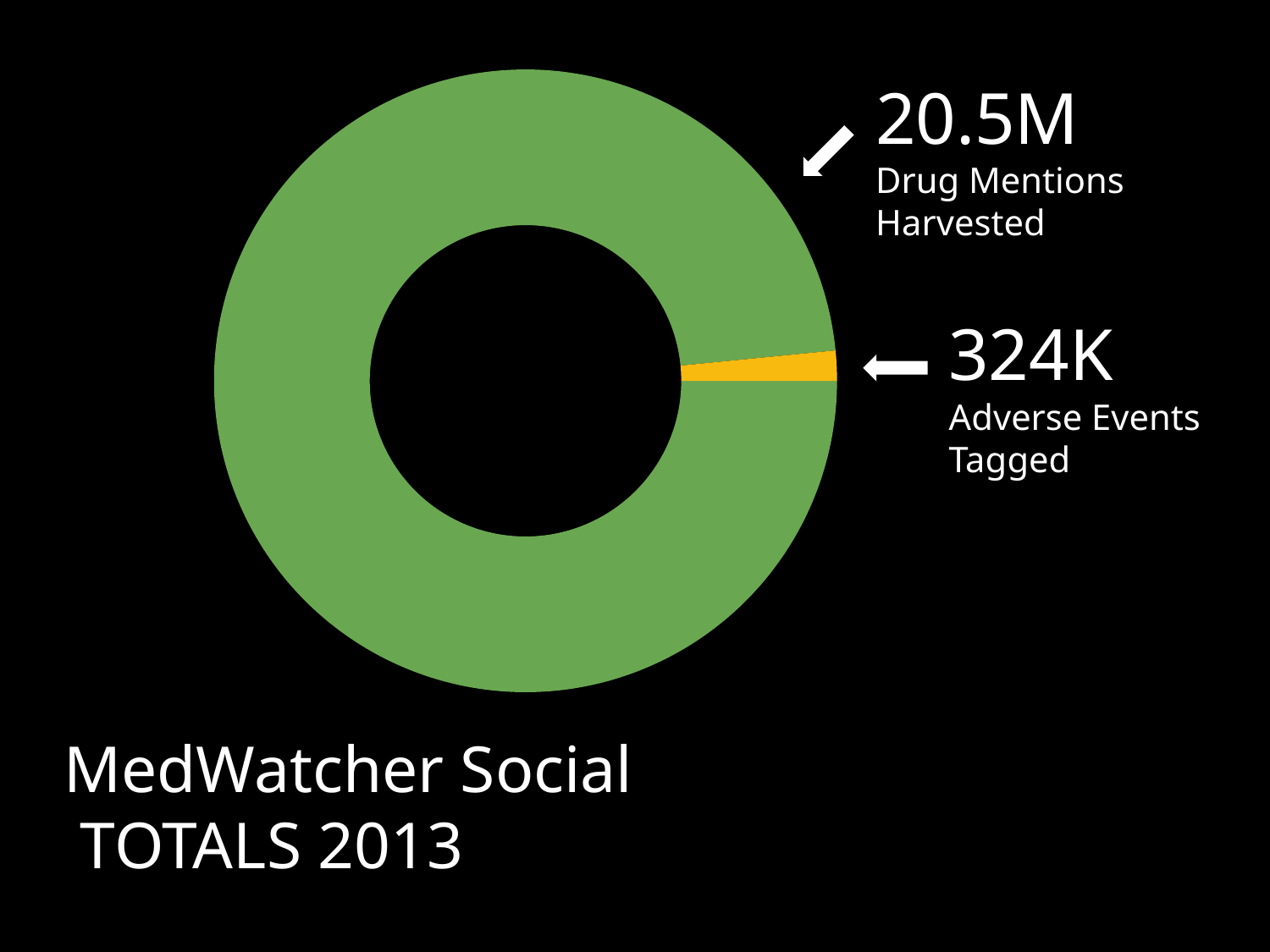
How many categories are shown in the chart? 2 What is the title text shown below the chart? MedWatcher Social TOTALS 2013 What value is shown for Adverse Events Tagged? 324K What kind of chart is shown on the slide? donut chart Which category has the largest segment of the chart? Drug Mentions Harvested What colour is the segment for Adverse Events Tagged? yellow Which is larger, Drug Mentions Harvested or Adverse Events Tagged? Drug Mentions Harvested What value is shown for Drug Mentions Harvested? 20.5M Which category has the smallest segment of the chart? Adverse Events Tagged